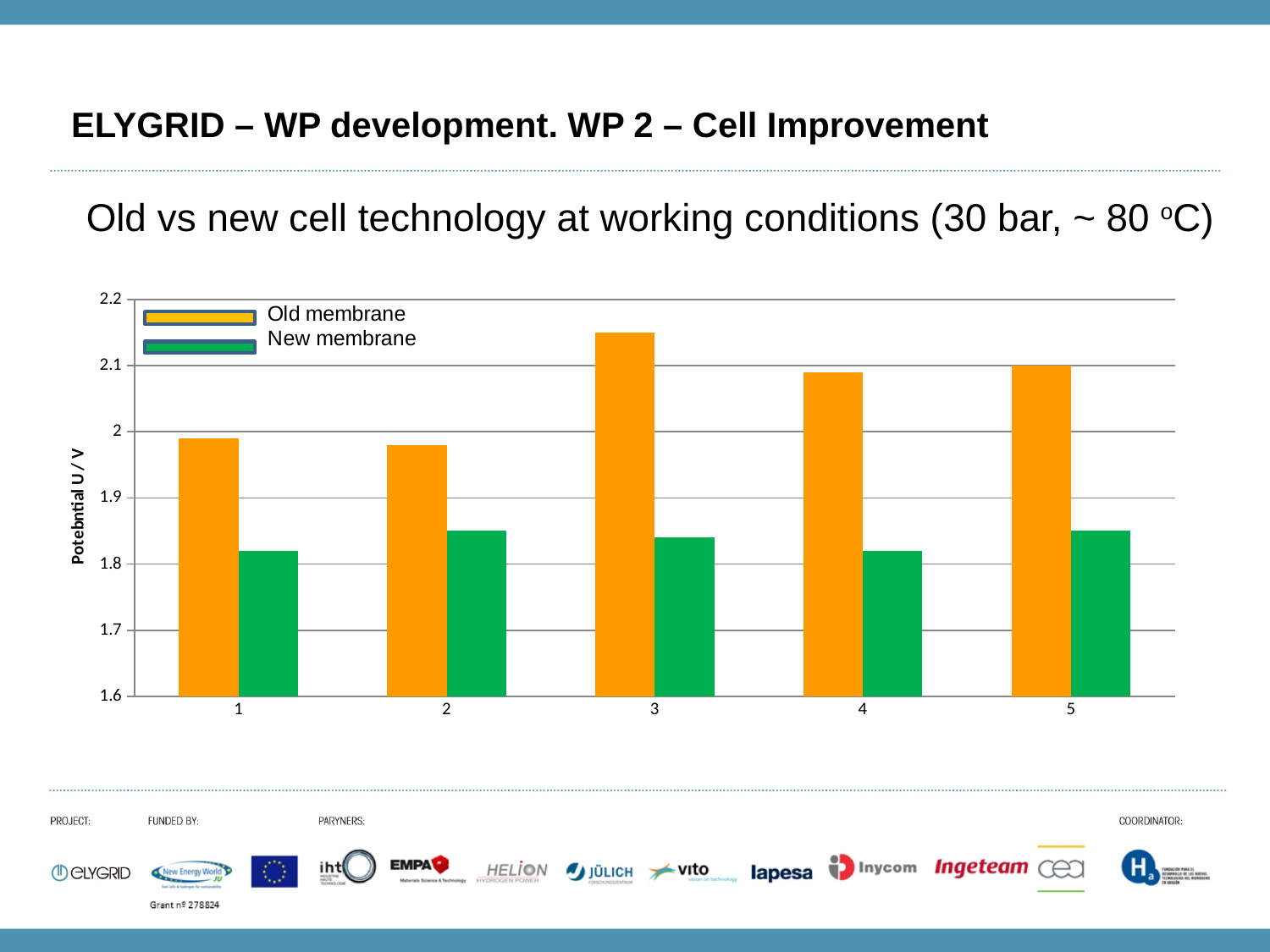
Which is larger, the Old membrane value for category 1 or for category 4? category 4 What kind of chart is shown on the slide? bar chart How many series does the legend list? 2 Is the New membrane value for category 2 greater or less than 1.8? greater How many categories are shown on the x axis? 5 Is the Old membrane value for category 4 greater or less than 2? greater Is the Old membrane value for category 3 greater or less than 2.1? greater For category 3, which series has the larger value, Old membrane or New membrane? Old membrane What colour are the New membrane bars? green Which category has the highest Old membrane value? 3 What are the two entries in the legend? Old membrane, New membrane